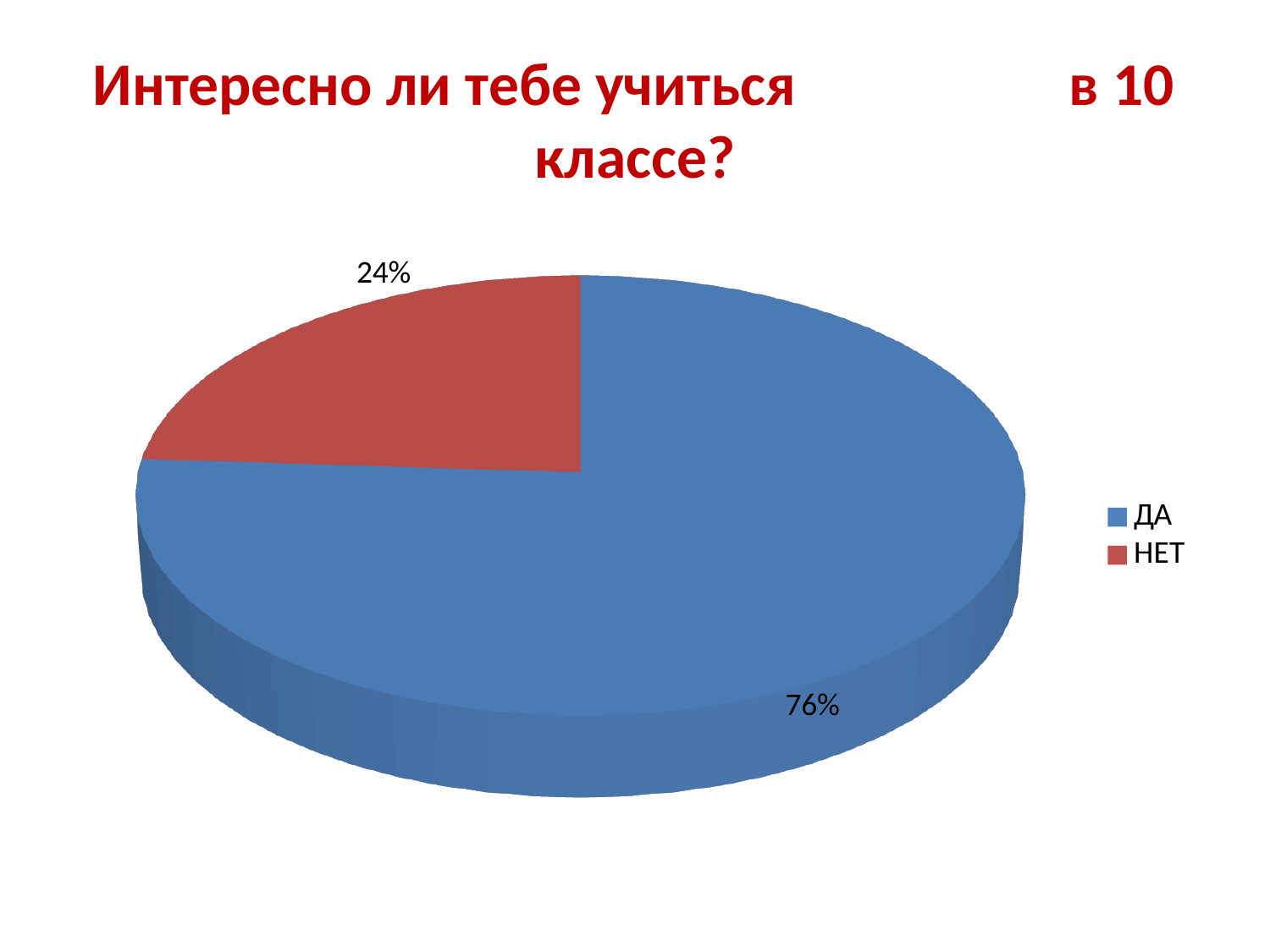
What share of the pie does the НЕТ slice represent? 24% What colour is the ДА slice? Blue What percentage of respondents answered ДА? 76% What is the title of the slide? Интересно ли тебе учиться в 10 классе? Which answer has the largest share of the pie? ДА What is the difference in percentage points between the ДА and НЕТ slices? 52 How many entries does the legend list? 2 What percentage of respondents answered НЕТ? 24% How many slices does the pie chart have? 2 Which answer has the smallest share of the pie? НЕТ Which slice is larger, ДА or НЕТ? ДА What kind of chart is shown on the slide? Pie chart